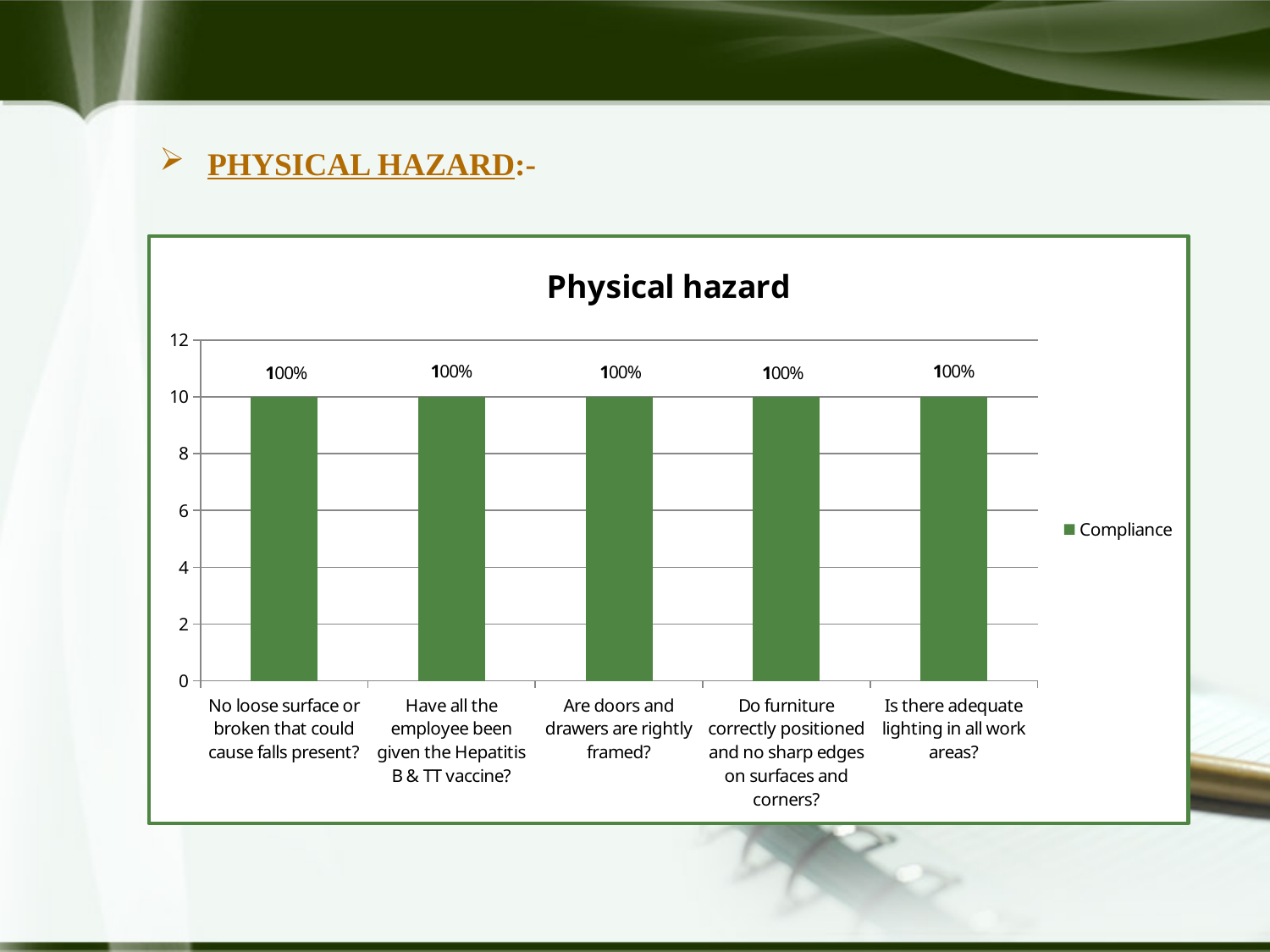
What is the title of the chart? Physical hazard What is the data label shown for 'Is there adequate lighting in all work areas?' 100% What is the data label shown for 'Have all the employee been given the Hepatitis B & TT vaccine?' 100% What series name appears in the legend? Compliance How many categories are plotted in the Physical hazard chart? 5 Is the bar for 'No loose surface or broken that could cause falls present?' greater or less than 8 on the vertical axis? greater What type of chart is shown on the slide? bar chart What is the data label shown for 'Are doors and drawers are rightly framed?' 100% Is the bar for 'Do furniture correctly positioned and no sharp edges on surfaces and corners?' greater or less than 12 on the vertical axis? less What is the difference between the labelled values for 'No loose surface or broken that could cause falls present?' and 'Is there adequate lighting in all work areas?' 0% Do the values rise, fall, or stay the same across the categories from left to right? stay the same How many series does the legend list? 1